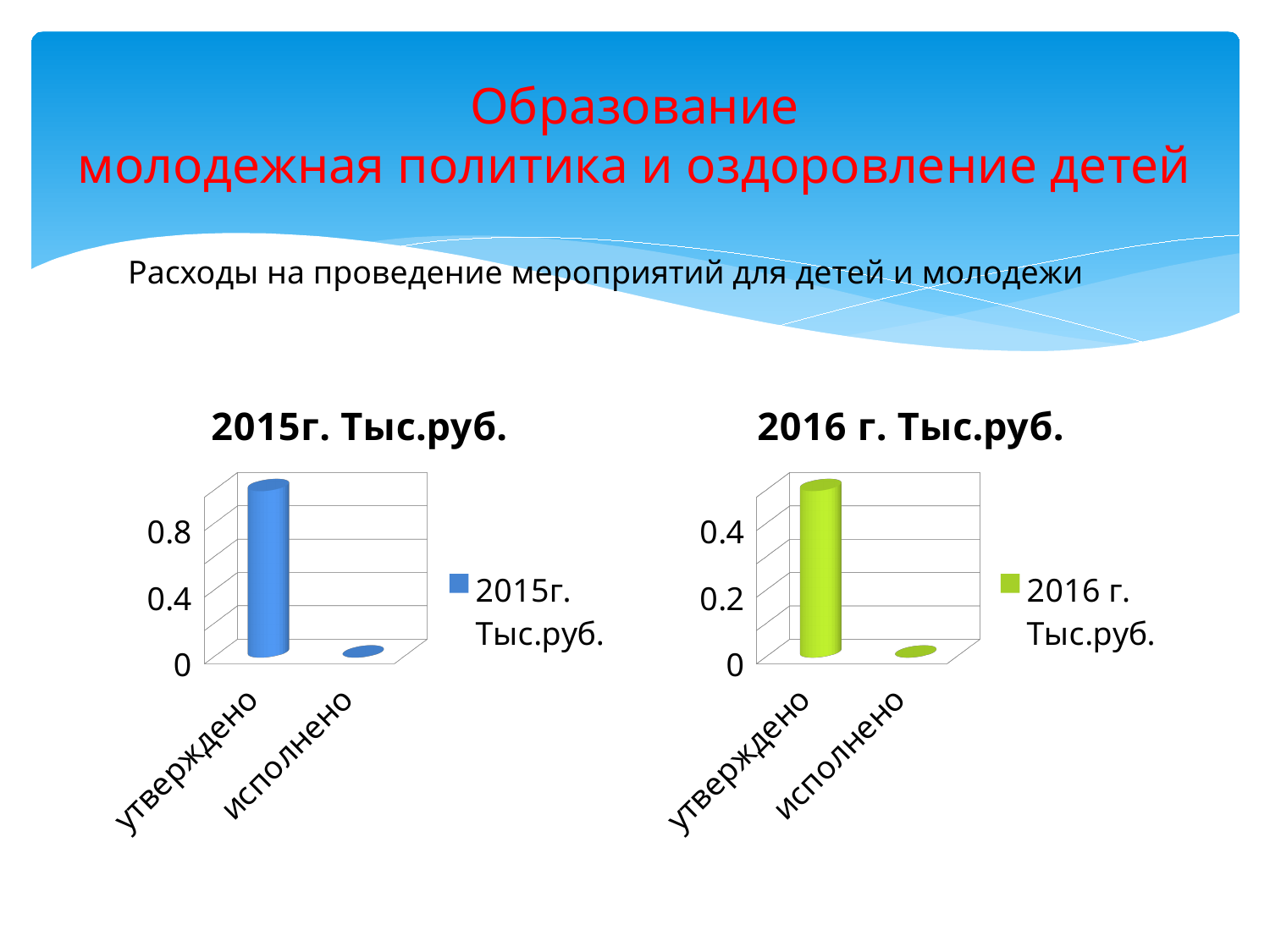
In the chart titled "2015г. Тыс.руб.", is the value for исполнено greater or less than 0.4? less What is the legend entry of the chart on the right side of the slide? 2016 г. Тыс.руб. In the chart titled "2015г. Тыс.руб.", is the value for утверждено greater or less than 0.8? greater How many categories are shown in the chart titled "2015г. Тыс.руб."? 2 In the chart titled "2015г. Тыс.руб.", which category has the lowest value? исполнено How many series does the legend of the chart titled "2016 г. Тыс.руб." list? 1 In the chart titled "2016 г. Тыс.руб.", is the value for утверждено greater or less than 0.4? greater In the chart titled "2015г. Тыс.руб.", which category has the highest value? утверждено In the chart titled "2016 г. Тыс.руб.", which is larger, утверждено or исполнено? утверждено What kind of chart is the chart titled "2015г. Тыс.руб."? bar chart In the chart titled "2016 г. Тыс.руб.", which category has the highest value? утверждено